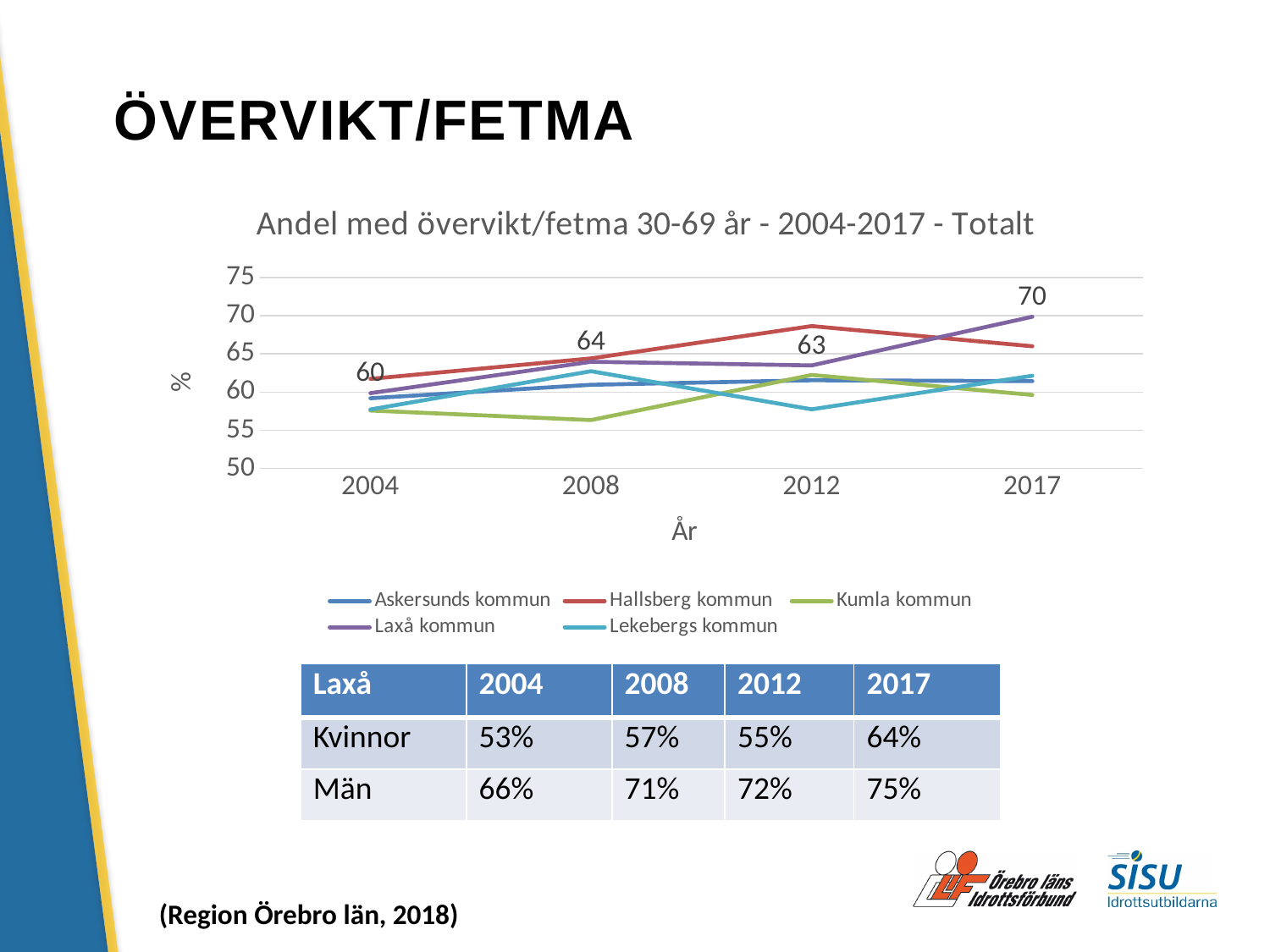
What is the value for Laxå kommun in 2008? 64 How many series does the chart legend list? 5 What is the value for Laxå kommun in 2004? 60 What kind of chart is shown on the slide? line chart Which municipality has the lowest value in 2008? Kumla kommun Is the value for Hallsberg kommun in 2012 greater or less than 65? greater What is the title of the x axis of the chart? År By how much did the value for Laxå kommun increase from 2004 to 2017? 10 Which is larger in 2012, the value for Hallsberg kommun or for Askersunds kommun? Hallsberg kommun Which municipality has the highest value in 2017? Laxå kommun What is the value for Laxå kommun in 2017? 70 How many years are plotted along the x axis of the chart? 4